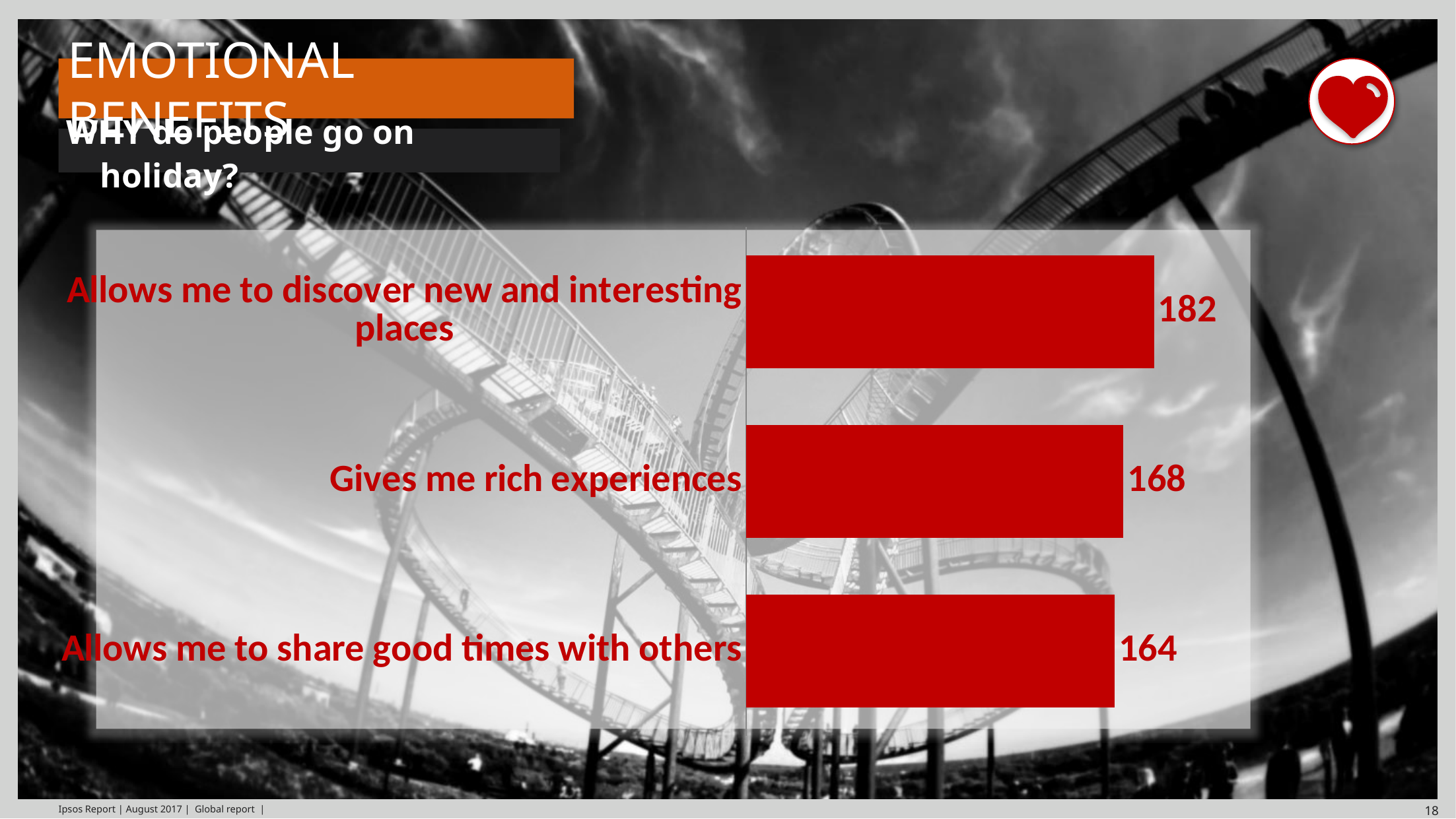
What is the value for "Allows me to share good times with others"? 164 What colour are the bars in the chart? Red What is the value for "Allows me to discover new and interesting places"? 182 What kind of chart is shown on the slide? Bar chart Which category has the lowest value? Allows me to share good times with others What is the difference between the values for "Gives me rich experiences" and "Allows me to share good times with others"? 4 What is the difference between the values for "Allows me to discover new and interesting places" and "Gives me rich experiences"? 14 What is the value for "Gives me rich experiences"? 168 How many categories are shown in the chart? 3 What question does the slide say the chart answers? WHY do people go on holiday? Which is larger: the value for "Allows me to discover new and interesting places" or "Allows me to share good times with others"? Allows me to discover new and interesting places Which category has the highest value? Allows me to discover new and interesting places